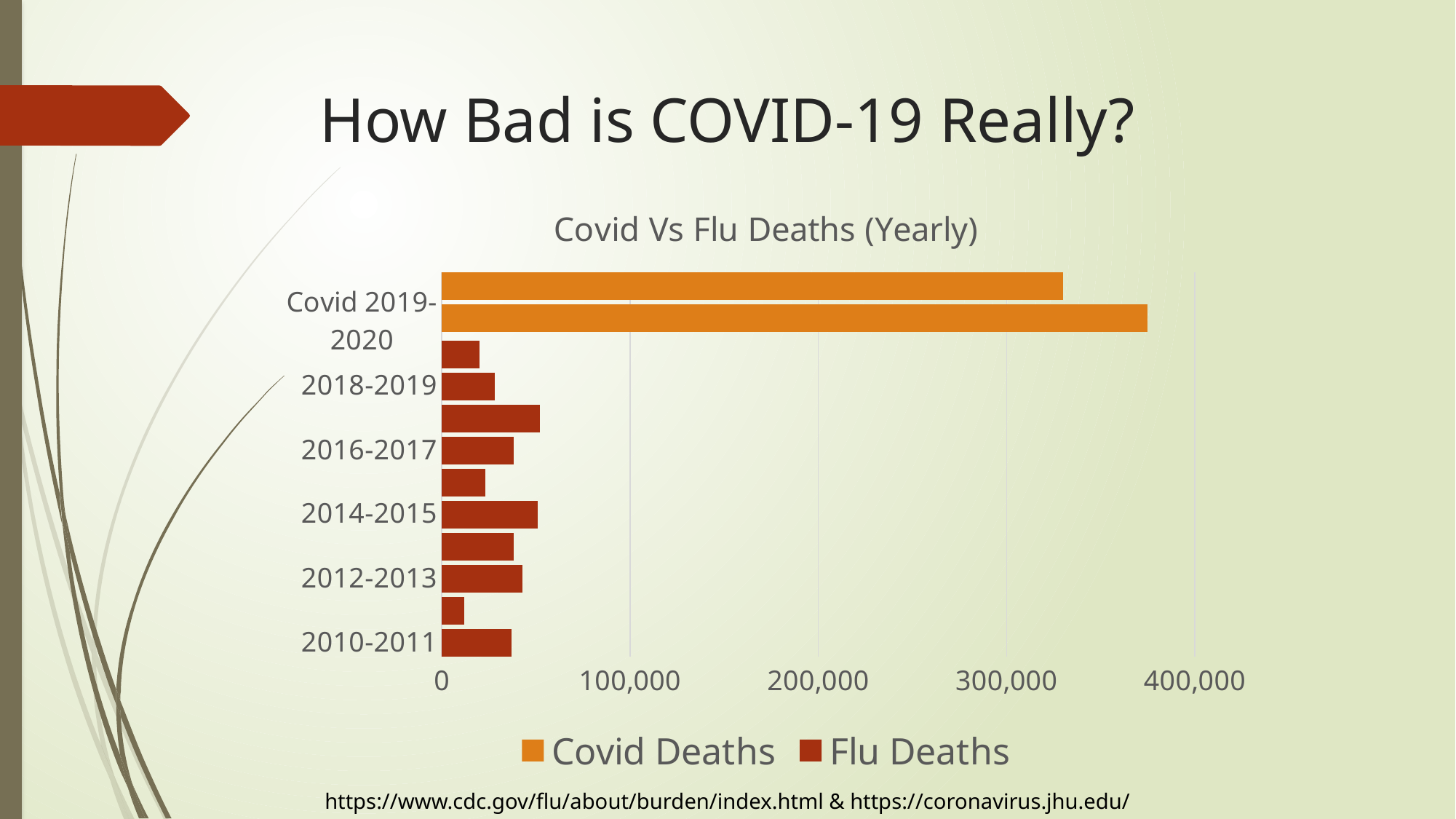
How many series does the legend list? 2 Which category has the highest value in the chart? Covid 2019-2020 Is the value for 2018-2019 greater or less than 100,000? less What is the title of the chart? Covid Vs Flu Deaths (Yearly) Is the value for Covid 2019-2020 greater or less than 300,000? greater What kind of chart is shown on the slide? bar chart Which series is shown in orange in the legend? Covid Deaths Which is larger, the value for Covid 2019-2020 or the value for 2018-2019? Covid 2019-2020 Which series has the larger values, Covid Deaths or Flu Deaths? Covid Deaths Is the value for 2010-2011 greater or less than 100,000? less Which is larger, the value for 2016-2017 or the value for Covid 2019-2020? Covid 2019-2020